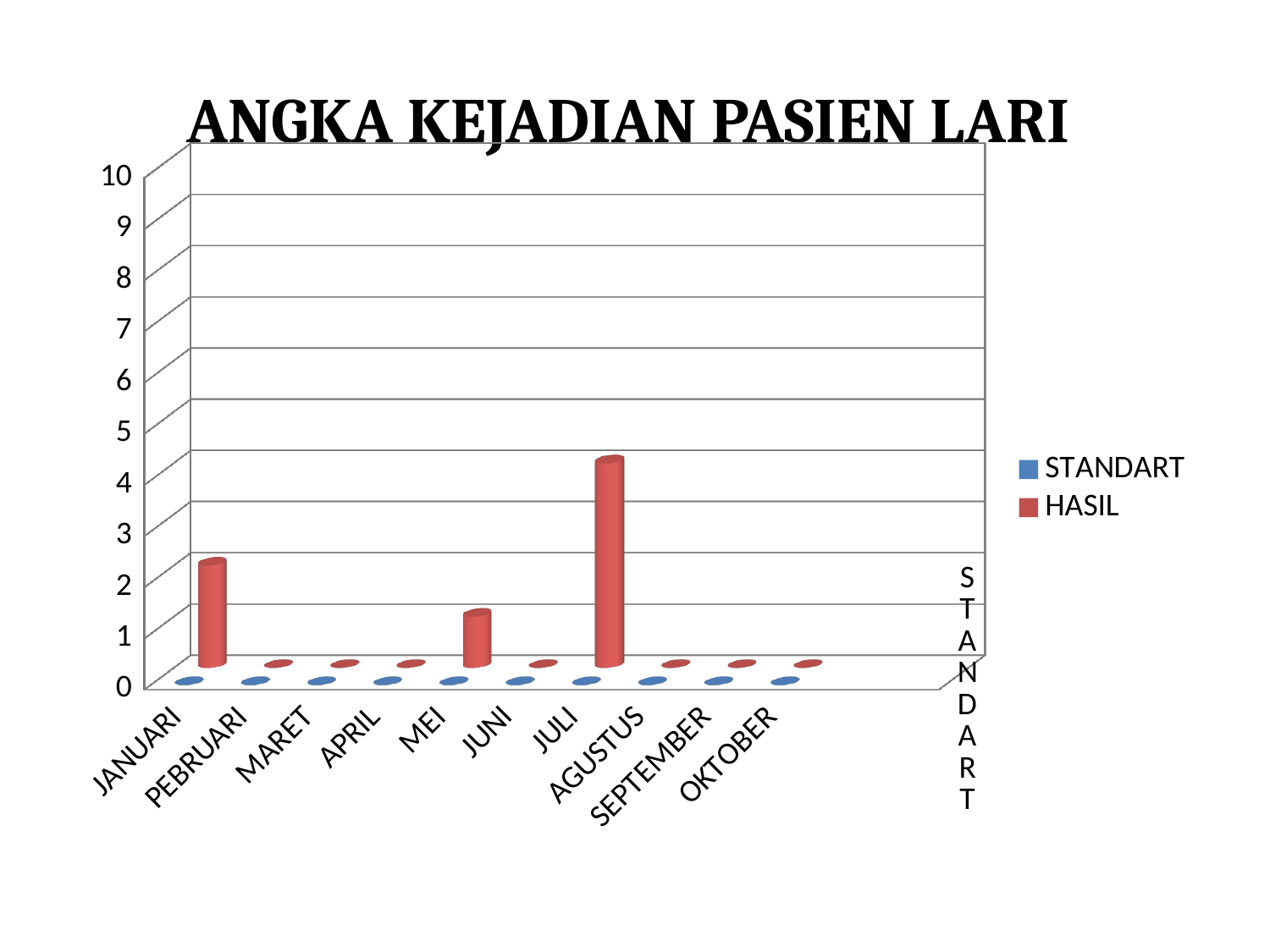
What kind of chart is shown on the slide? bar chart Which colour represents the HASIL series in the legend? red Which has the larger HASIL value, JANUARI or MEI? JANUARI What is the title of the chart? ANGKA KEJADIAN PASIEN LARI Is the HASIL value for MEI greater or less than 2? less How many months are shown on the x axis? 10 What is the highest value shown on the vertical axis? 10 Is the HASIL value for JULI greater or less than 3? greater How many series does the legend list? 2 Which has the larger HASIL value, JULI or JANUARI? JULI Which month has the highest HASIL value? JULI Is the HASIL value for JANUARI greater or less than 3? less